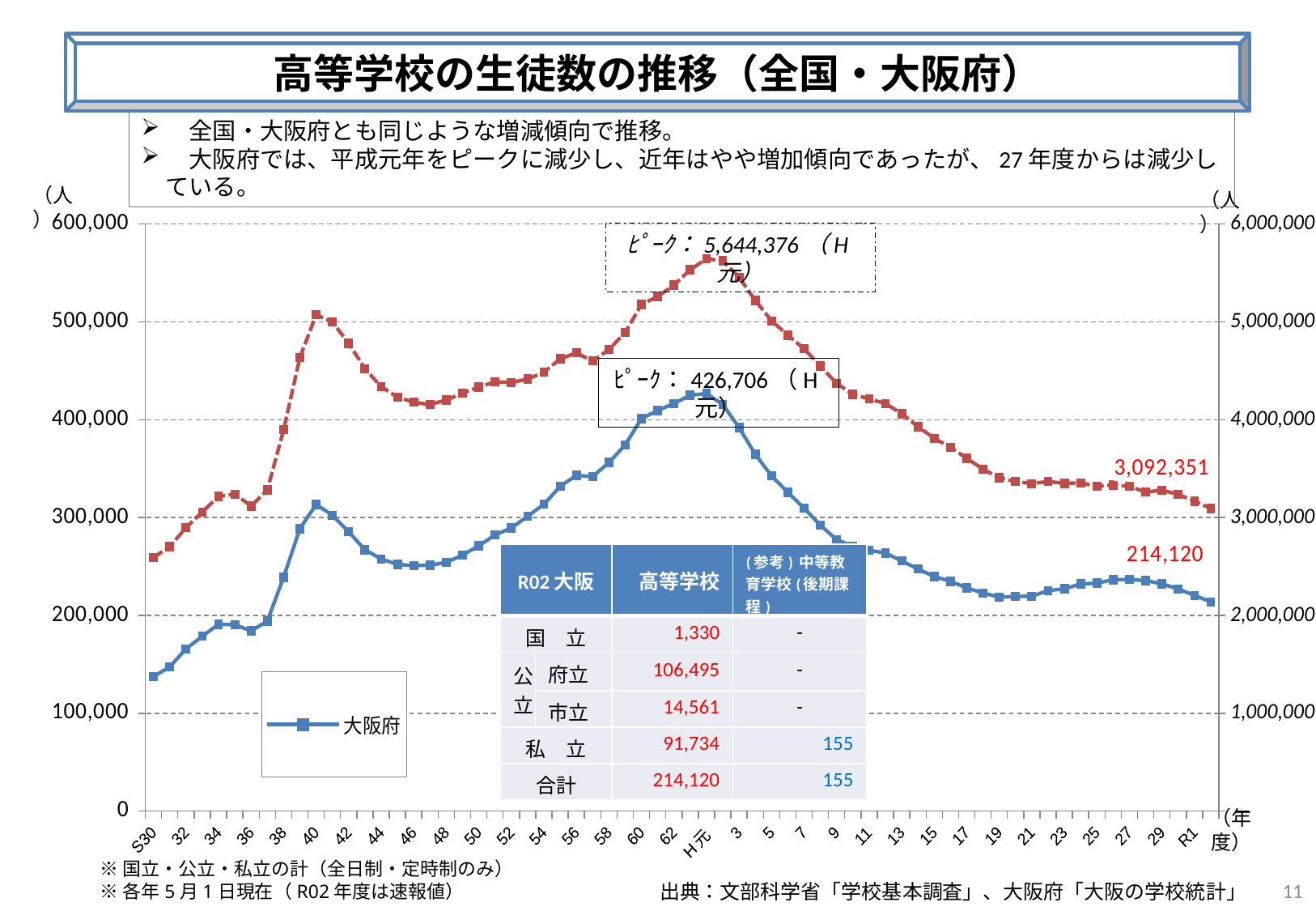
Is the value for 大阪府 at S30 greater or less than 200,000? less Is the value for 大阪府 at year 40 greater or less than 250,000? greater What is the peak value of the 大阪府 series, as labelled on the chart? 426,706 In which year did the 大阪府 series reach its peak, according to the label on the chart? H元 What kind of chart is shown on the slide? line chart What is the most recent value labelled for the national series at the right end of the chart? 3,092,351 What is the most recent value labelled for the 大阪府 series at the right end of the chart? 214,120 Does the 大阪府 series rise or fall between H元 and H11? fall What is the difference between the national peak (5,644,376) and its latest labelled value (3,092,351)? 2,552,025 What is the difference between the 大阪府 peak (426,706) and its latest labelled value (214,120)? 212,586 What is the peak value of the national (全国) series, as labelled on the chart? 5,644,376 What is the maximum value shown on the left vertical axis? 600,000